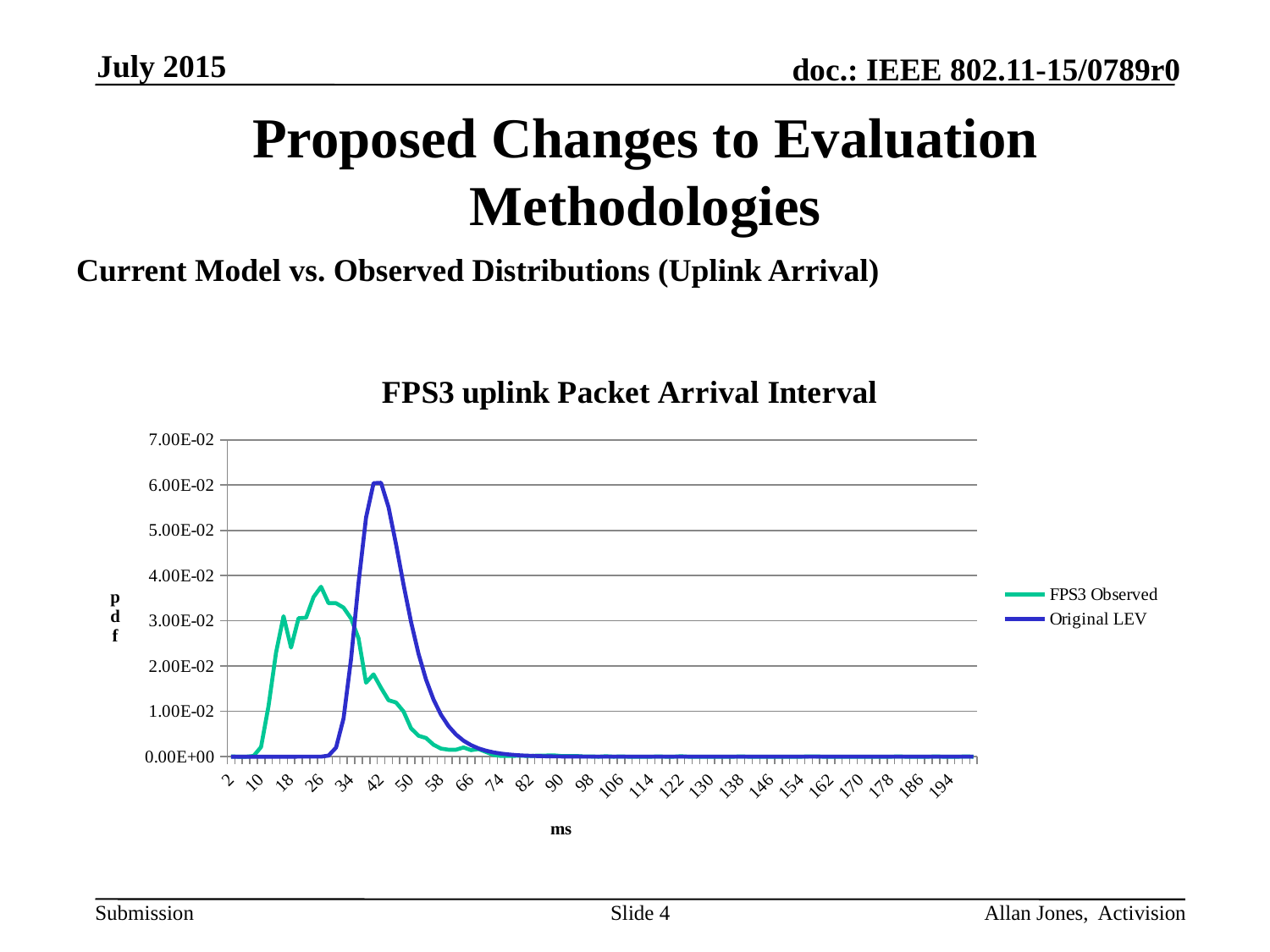
What is the title of the chart? FPS3 uplink Packet Arrival Interval How many series does the legend of the chart list? 2 After their peaks, do the values of both series rise or fall as ms increases? fall Is the peak value of the FPS3 Observed series greater or less than 3.00E-02? greater What is the highest tick value shown on the vertical axis of the chart? 7.00E-02 Which two series are listed in the chart's legend? FPS3 Observed and Original LEV Which series reaches the higher peak value, FPS3 Observed or Original LEV? Original LEV Which series reaches its peak at a larger ms value, FPS3 Observed or Original LEV? Original LEV What kind of chart is shown on the slide? line chart Is the peak value of the FPS3 Observed series greater or less than 5.00E-02? less Is the peak value of the Original LEV series greater or less than 5.00E-02? greater